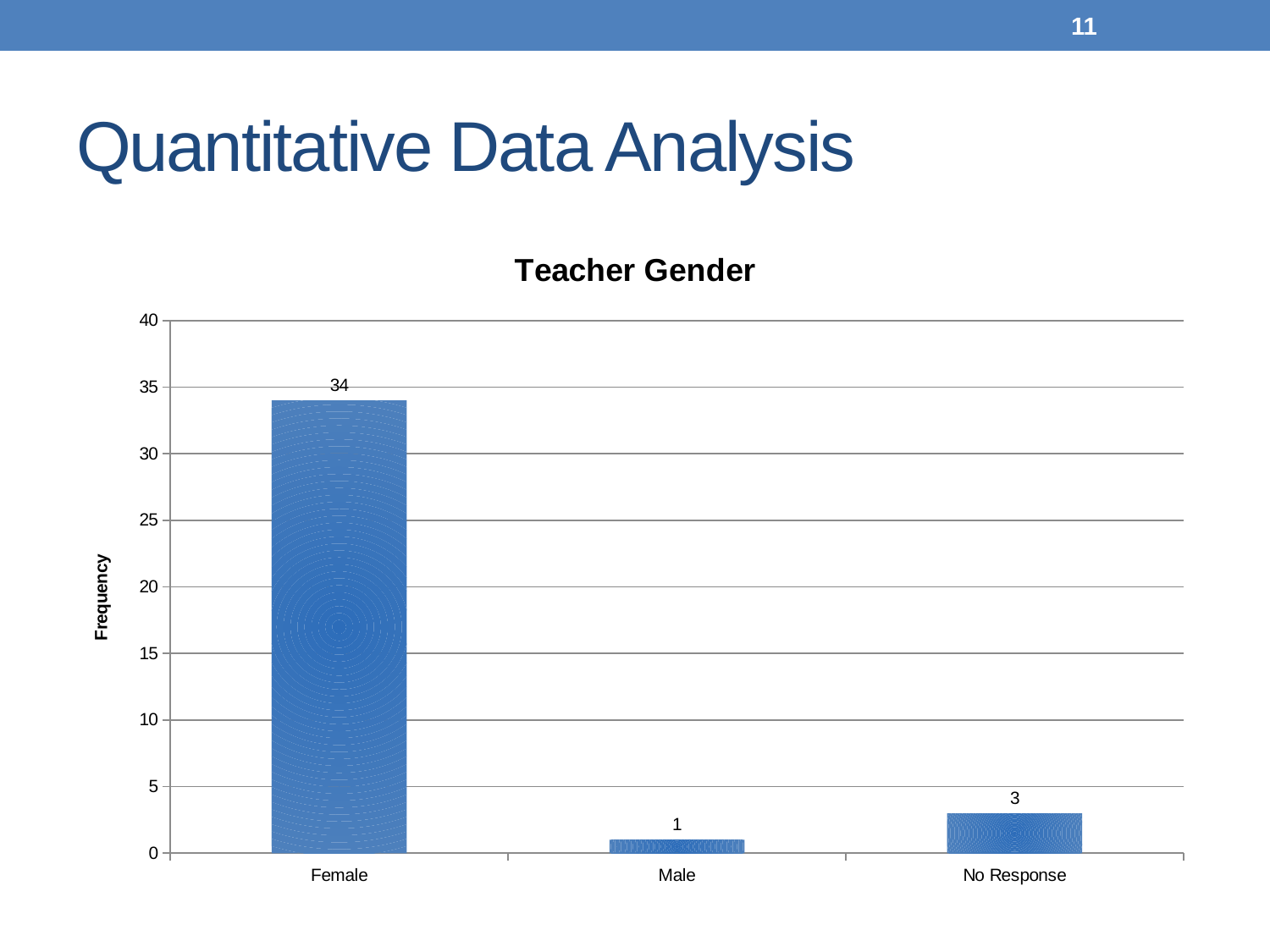
Which category has the highest frequency? Female What kind of chart is shown on the slide? bar chart What is the frequency for Male? 1 How many categories are shown on the x axis? 3 Which is larger, the frequency for Male or for No Response? No Response What is the difference between the Female and Male frequencies? 33 Which category has the lowest frequency? Male What is the title of the chart? Teacher Gender Is the value for Female greater or less than 30? greater What is the frequency for No Response? 3 What is the frequency for Female? 34 What is the difference between the No Response and Male frequencies? 2